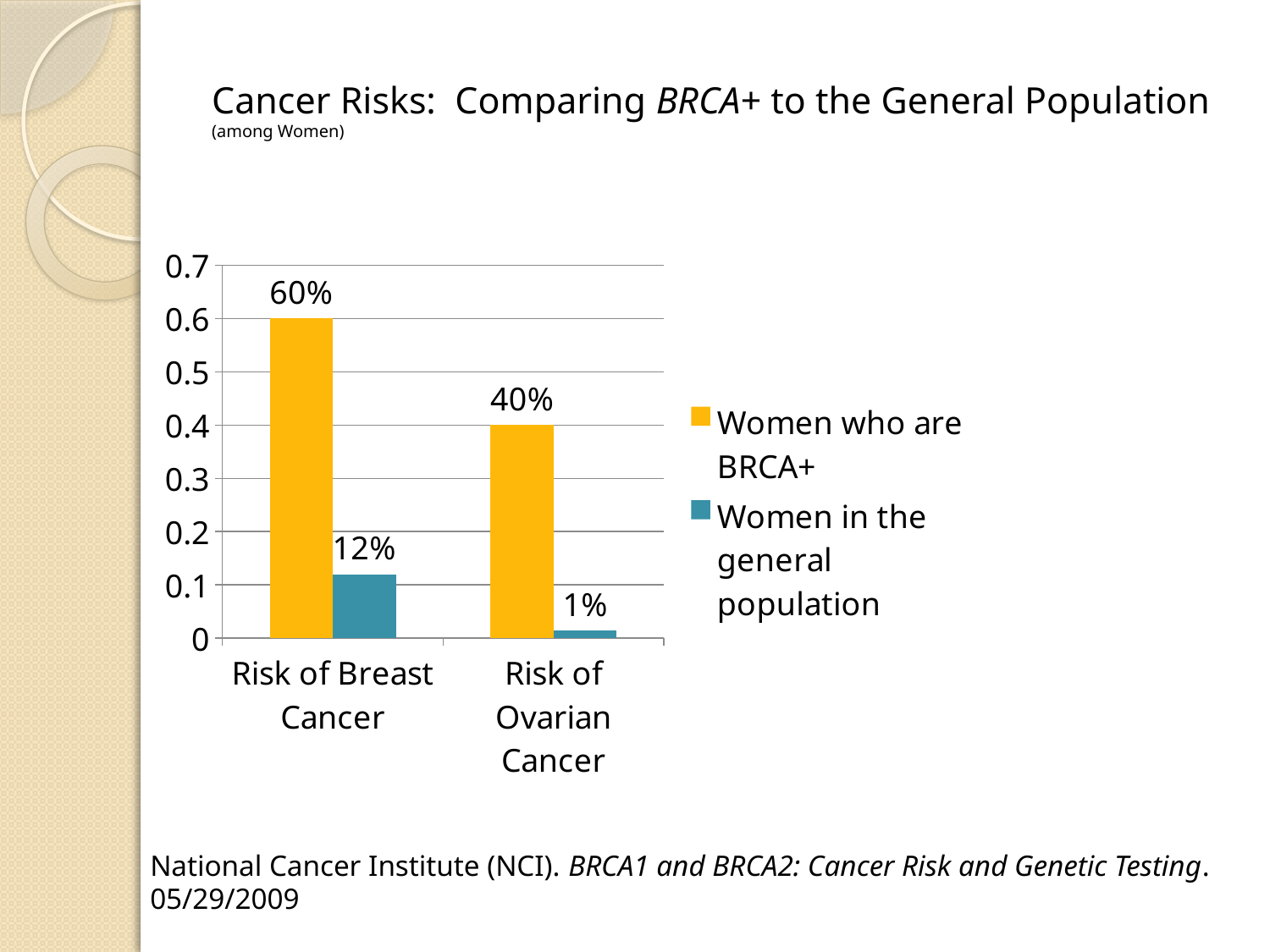
What is the risk of ovarian cancer for women in the general population? 1% Which category has the lowest value for women in the general population? Risk of Ovarian Cancer What kind of chart is shown on the slide? Bar chart What is the risk of ovarian cancer for women who are BRCA+? 40% What is the risk of breast cancer for women who are BRCA+? 60% How many categories are shown on the x axis? 2 How many series does the legend list? 2 What is the difference between the breast cancer risk for women who are BRCA+ and for women in the general population? 48% Which category has the highest value for women who are BRCA+? Risk of Breast Cancer Which is larger: the ovarian cancer risk for women who are BRCA+ or the breast cancer risk for women in the general population? Ovarian cancer risk for women who are BRCA+ What is the risk of breast cancer for women in the general population? 12% What is the difference between the ovarian cancer risk for women who are BRCA+ and for women in the general population? 39%